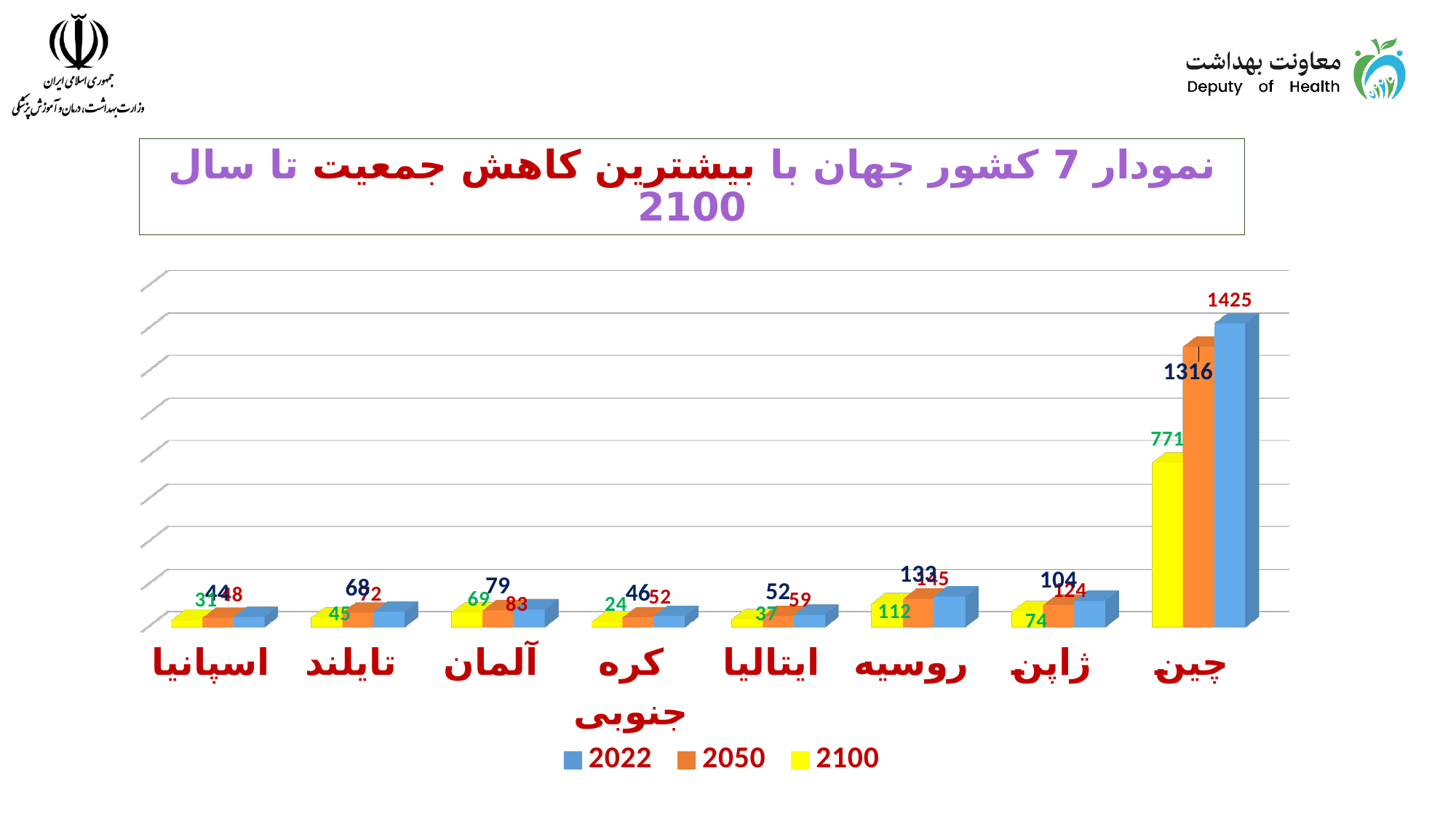
Which category has the highest 2022 value? چین How many categories are shown on the x axis? 8 What is the difference between the 2022 and 2100 values for چین? 654 What kind of chart is shown on the slide? bar chart How many series does the legend list? 3 What is the 2100 value for چین? 771 Which category has the lowest 2100 value? کره جنوبی Which is larger, the 2022 value for ژاپن or the 2022 value for ایتالیا? ژاپن What is the 2022 value for چین? 1425 What is the 2100 value for کره جنوبی? 24 What is the 2022 value for آلمان? 83 What is the 2050 value for ژاپن? 104